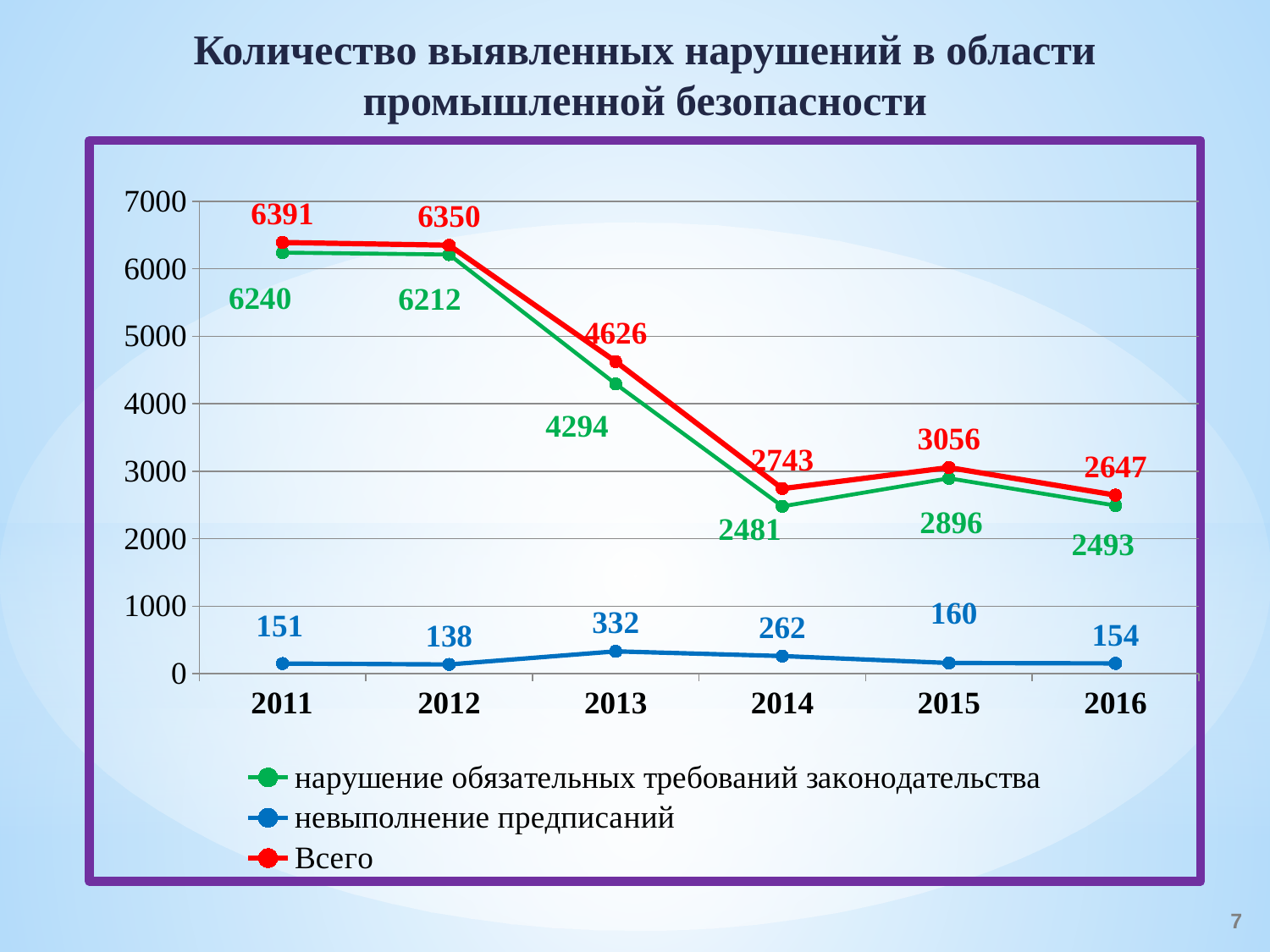
In which year is the "Всего" series highest? 2011 Does the "Всего" series generally rise or fall from 2011 to 2016? Fall What is the value of the "Всего" series in 2013? 4626 How many years are plotted along the x axis? 6 How many series does the legend list? 3 What is the difference between the "Всего" values in 2011 and 2016? 3744 In which year is the "невыполнение предписаний" series lowest? 2012 What is the value of the "нарушение обязательных требований законодательства" series in 2015? 2896 What kind of chart is shown on the slide? Line chart What colour is the line for the "Всего" series? Red What is the value of the "невыполнение предписаний" series in 2014? 262 Which is larger: the "нарушение обязательных требований законодательства" value in 2014 or in 2016? 2016